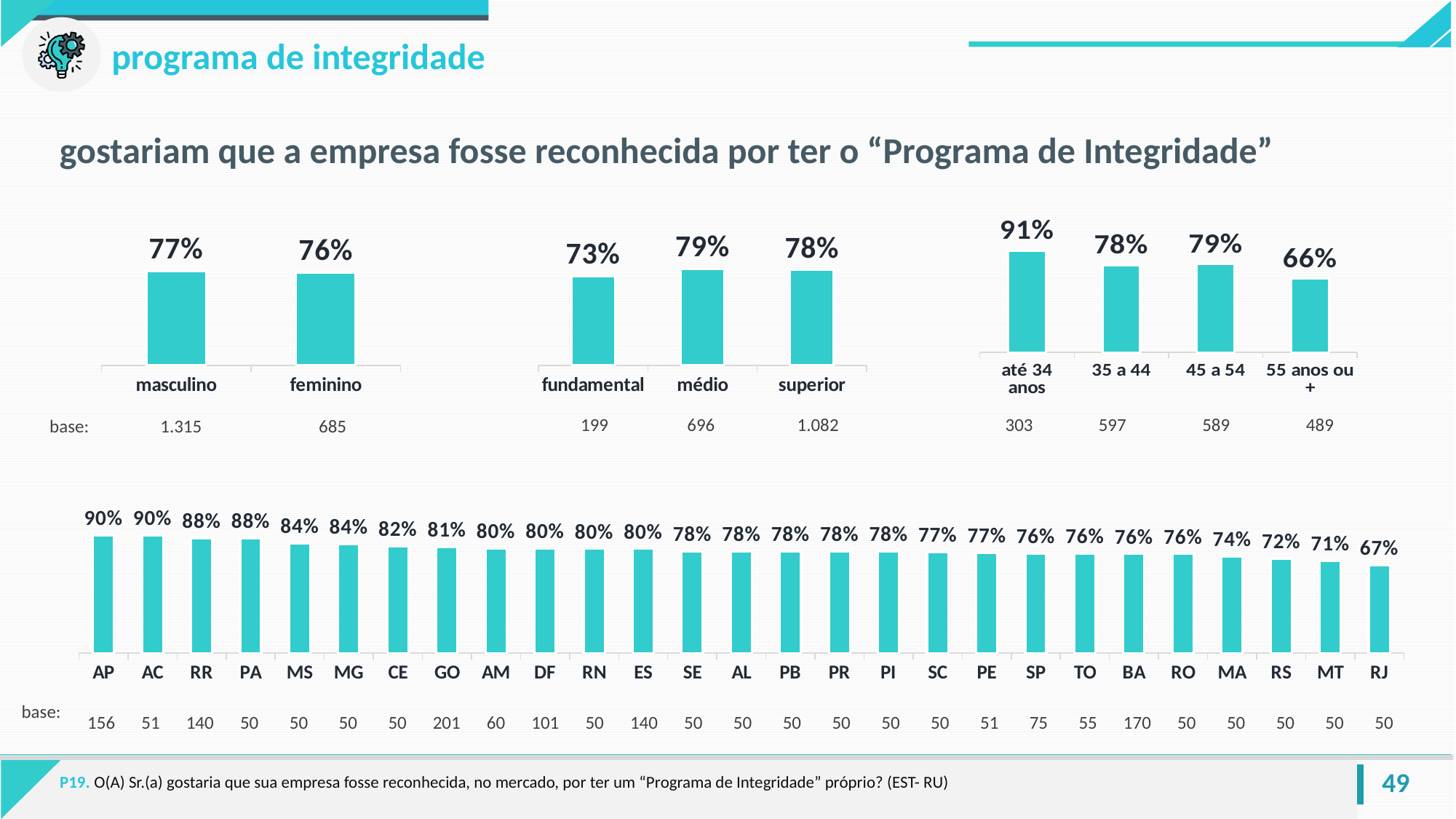
In the top-right chart by age group, which age group has the highest value? até 34 anos In the top-middle chart by education level, what is the value for fundamental? 73% In the bottom chart by state, which state has the lowest value? RJ In the top-left chart by gender, what is the value for masculino? 77% In the top-middle chart by education level, what is the difference between médio and fundamental? 6 percentage points What kind of chart is the bottom chart by state? bar chart In the top-left chart by gender, which category is larger, masculino or feminino? masculino In the top-right chart by age group, how many age groups are shown? 4 In the bottom chart by state, how many states are shown? 27 In the top-right chart by age group, what is the value for 55 anos ou +? 66% In the top-middle chart by education level, which category has the highest value? médio In the bottom chart by state, what is the value for MG? 84%